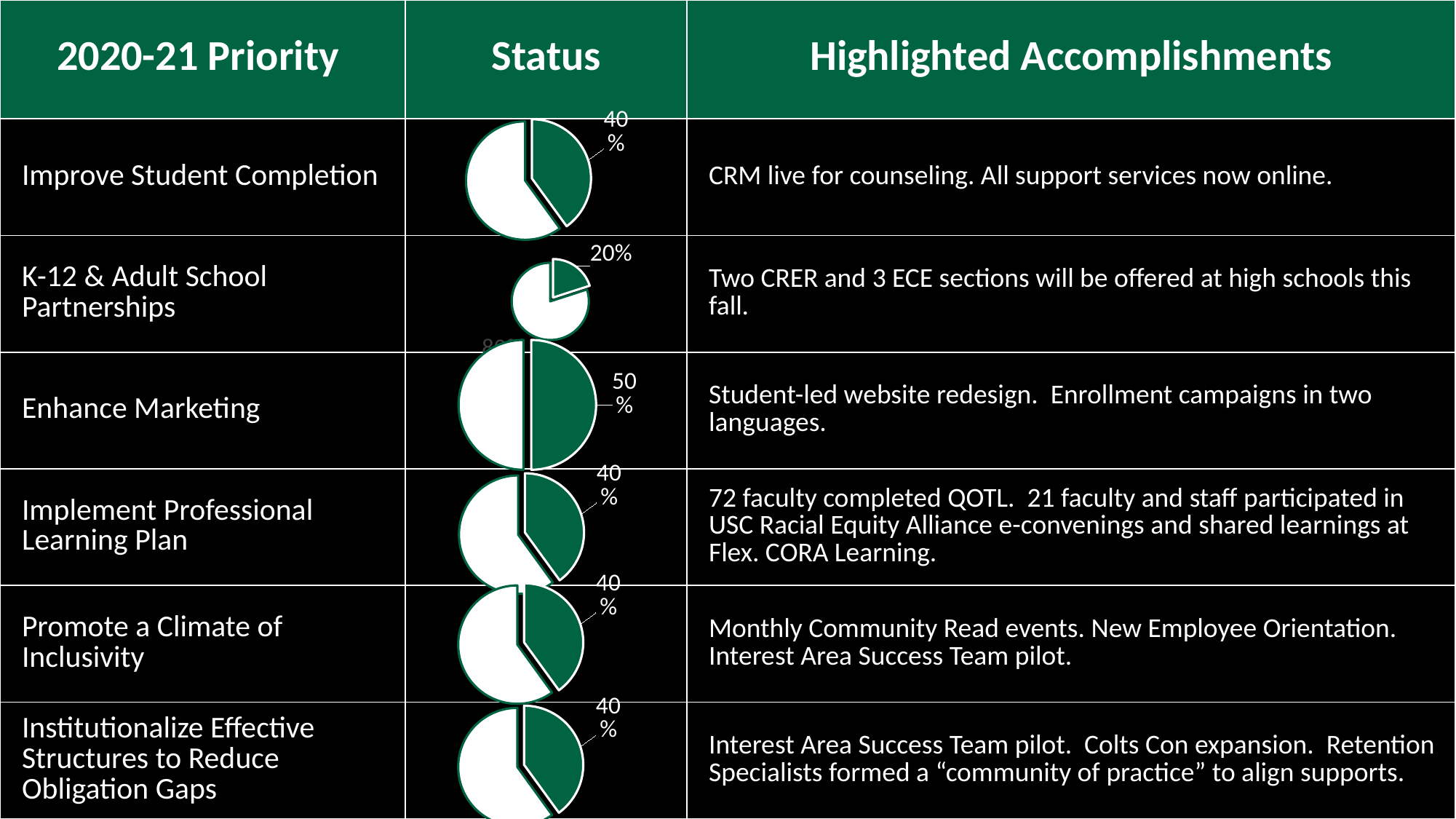
In the Status pie chart for the 'Institutionalize Effective Structures to Reduce Obligation Gaps' row, what percentage is labeled on the green slice? 40% How many pie charts are shown in the Status column of the slide? 6 What is the difference between the labeled percentage in the 'Enhance Marketing' pie chart and the 'K-12 & Adult School Partnerships' pie chart? 30% In the Status pie chart for the 'Implement Professional Learning Plan' row, what percentage is labeled on the green slice? 40% Which priority's Status pie chart shows the lowest labeled percentage? K-12 & Adult School Partnerships In the Status pie chart for the 'Enhance Marketing' row, what percentage is labeled on the green slice? 50% In the Status pie chart for the 'K-12 & Adult School Partnerships' row, what percentage is labeled on the green slice? 20% Which has a larger labeled percentage: the 'Enhance Marketing' pie chart or the 'Improve Student Completion' pie chart? Enhance Marketing In the Status pie chart for the 'Promote a Climate of Inclusivity' row, what percentage is labeled on the green slice? 40% In the Status pie chart for the 'Improve Student Completion' row, what percentage is labeled on the green slice? 40% What type of chart is used in the Status column of the table? Pie chart Which priority's Status pie chart shows the highest labeled percentage? Enhance Marketing